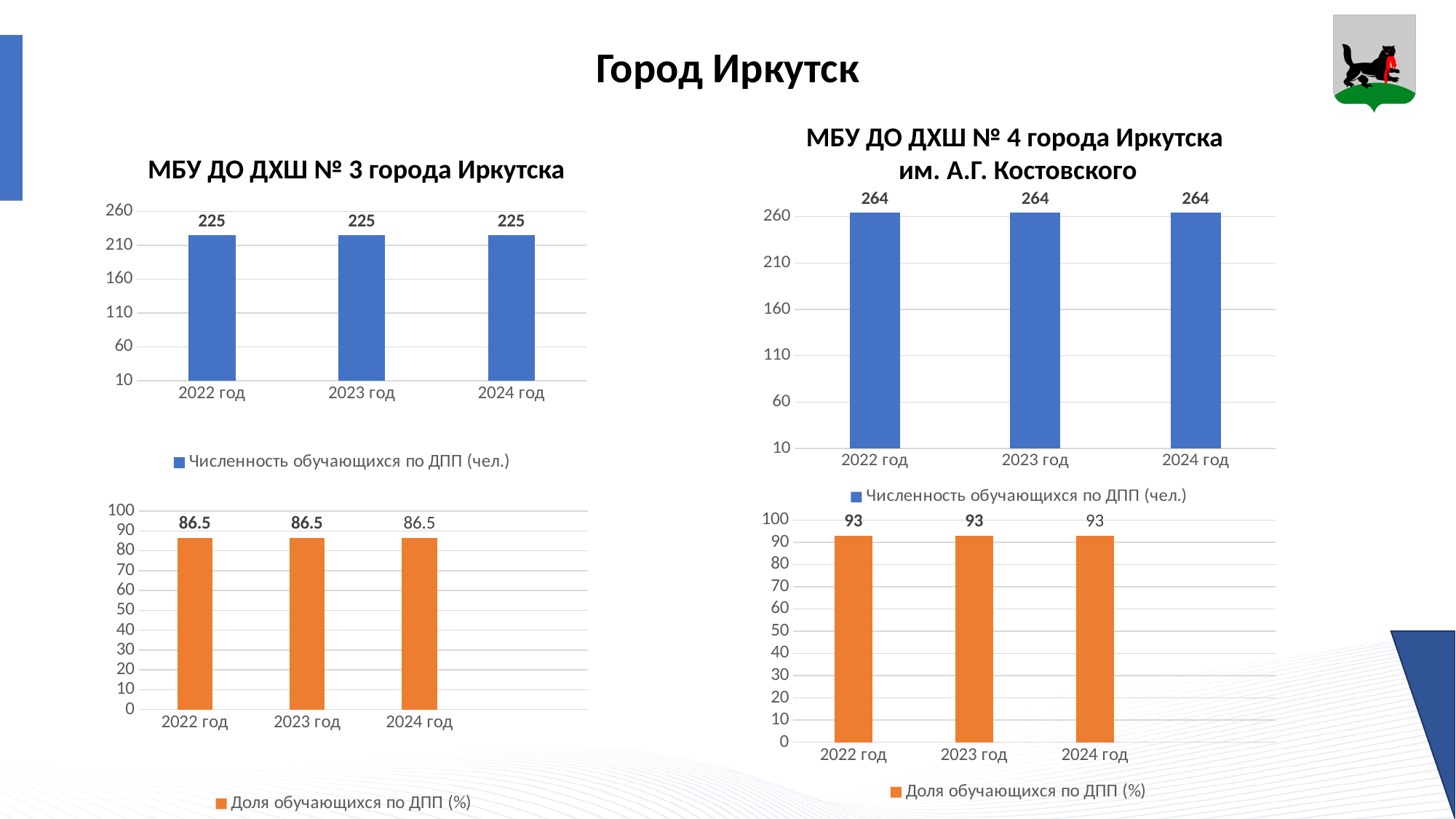
In the bottom-right orange chart (Доля обучающихся по ДПП (%)) under ДХШ № 4, what is the value for 2023 год? 93 In the top-left chart titled 'МБУ ДО ДХШ № 3 города Иркутска', what is the value for 2023 год? 225 In the top-right chart titled 'МБУ ДО ДХШ № 4 города Иркутска им. А.Г. Костовского', what is the value for 2024 год? 264 What is the legend entry of the top-left blue chart for ДХШ № 3? Численность обучающихся по ДПП (чел.) What kind of chart is the bottom-left chart showing Доля обучающихся по ДПП (%) for ДХШ № 3? Bar chart In the top-right chart for ДХШ № 4, how many series does the legend list? 1 Which is larger: the 2022 год value in the top-left chart for ДХШ № 3 or the 2022 год value in the top-right chart for ДХШ № 4? ДХШ № 4 (264) In the top-left chart for ДХШ № 3, do the values rise, fall, or stay the same from 2022 год to 2024 год? Stay the same In the bottom-left orange chart (Доля обучающихся по ДПП (%)) under ДХШ № 3, what is the value for 2022 год? 86.5 What is the difference between the 2024 год value in the top-right chart for ДХШ № 4 and the 2024 год value in the top-left chart for ДХШ № 3? 39 In the top-left chart for ДХШ № 3, how many categories are shown on the x axis? 3 In the bottom-right orange chart for ДХШ № 4, is the value for 2024 год greater or less than 90? greater